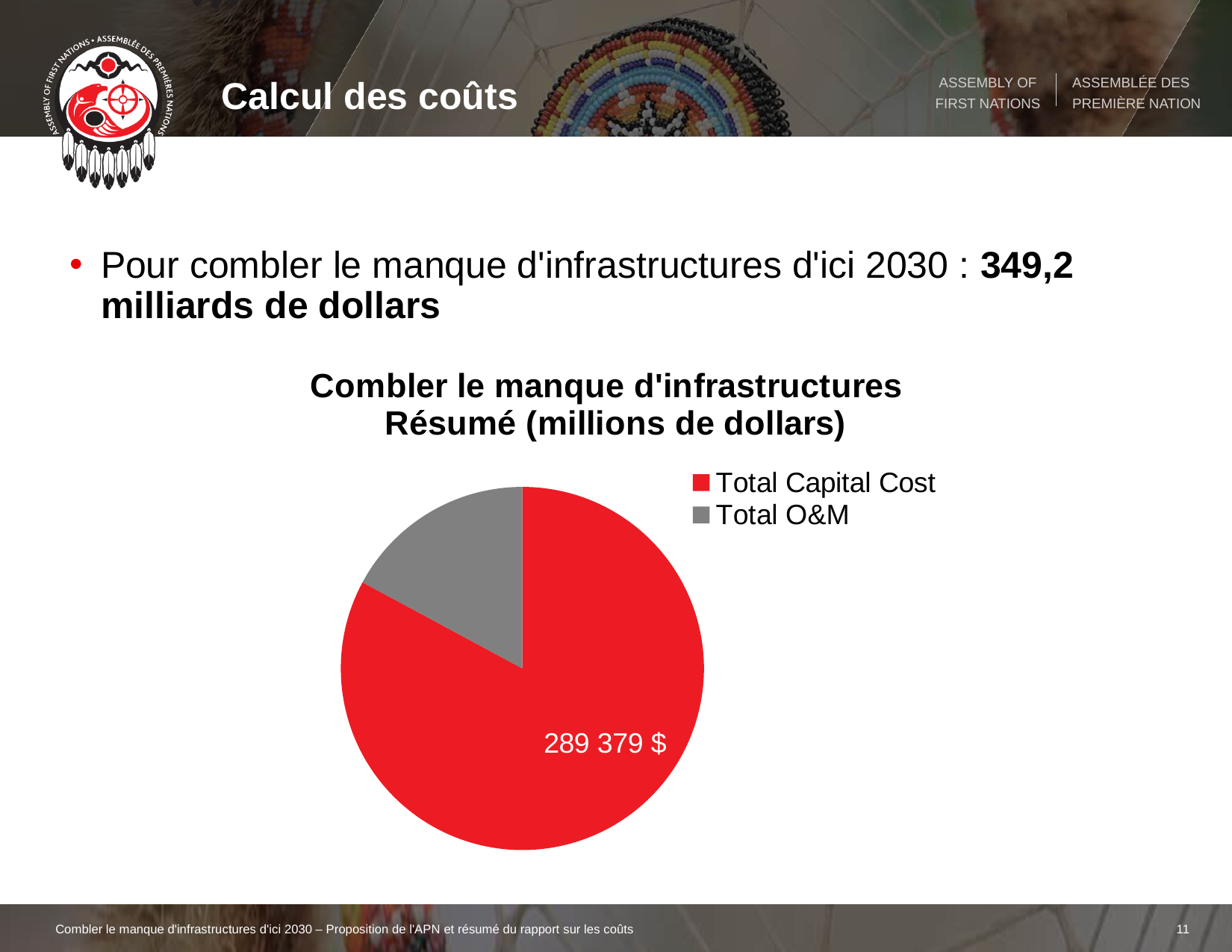
Which category has the smallest slice in the pie chart? Total O&M What value is shown for the Total Capital Cost slice of the pie chart? 289 379 $ How many entries does the legend of the pie chart list? 2 Which category has the largest slice in the pie chart? Total Capital Cost What is the title of the chart on the slide? Combler le manque d'infrastructures Résumé (millions de dollars) What colour is the Total O&M slice in the pie chart? Grey Which is larger in the pie chart, Total Capital Cost or Total O&M? Total Capital Cost How many slices does the pie chart have? 2 What kind of chart is shown on the slide? Pie chart